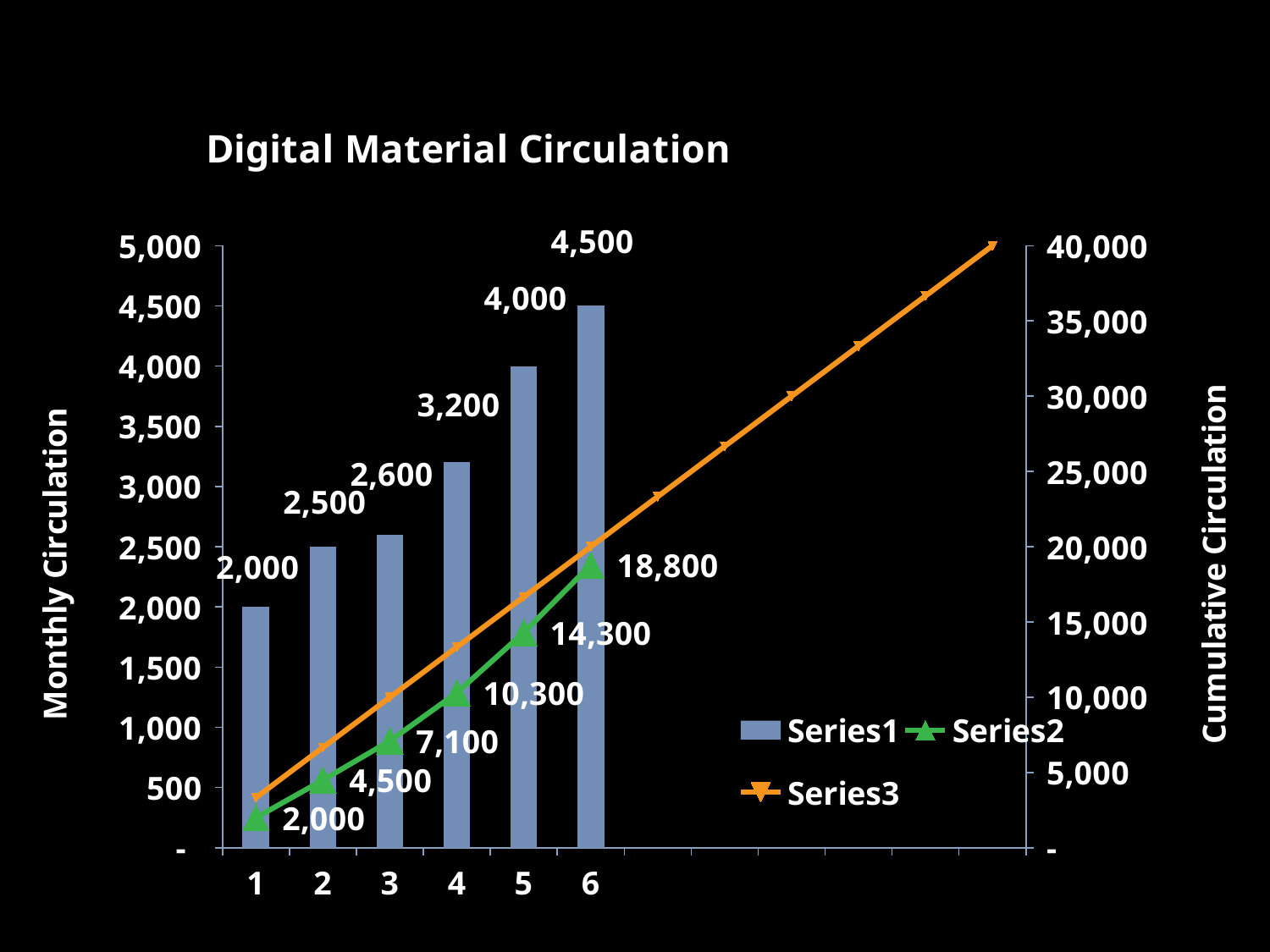
Which category has the highest Series1 bar? 6 Which is larger, the Series1 value for category 4 or for category 5? category 5 Is the Series3 value at category 6 greater or less than 15,000 on the right axis? greater How many bars are plotted for Series1? 6 How many series does the legend list? 3 What is the Series1 value for category 3? 2,600 Which category has the lowest Series1 bar? 1 Do the Series2 values rise or fall from category 1 to category 6? rise What is the title of the chart? Digital Material Circulation What is the difference between the Series1 values for category 6 and category 1? 2,500 What kind of chart is this? Combination bar and line chart What is the Series2 value at category 5? 14,300